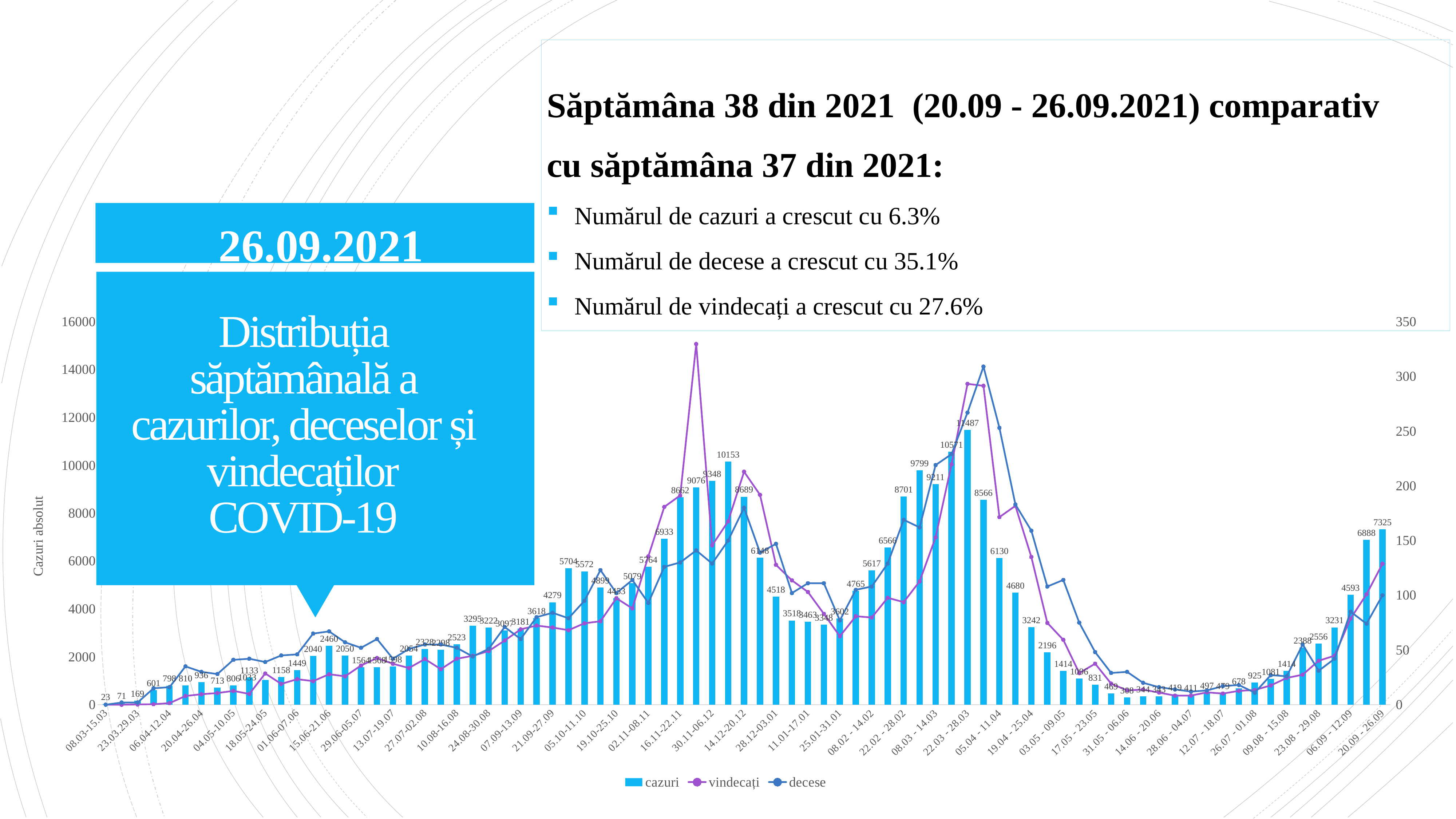
What kind of chart is shown on the slide? Combined bar and line chart Which week has the lowest number of cazuri? 08.03-15.03 What is the difference in cazuri between the weeks 20.09 - 26.09 and 06.09 - 12.09? 2732 What is the number of cazuri for the week 20.09 - 26.09? 7325 Which week has more cazuri, 05.10-11.10 or 19.10-25.10? 05.10-11.10 Which series is plotted as bars in the chart? cazuri How many series does the legend list? 3 What is the title of the vertical axis on the left of the chart? Cazuri absolut Which week has the highest number of cazuri? 22.03 - 28.03 Do the cazuri values rise or fall from the week 22.03 - 28.03 to the week 14.06 - 20.06? fall What is the number of cazuri for the week 22.03 - 28.03? 11487